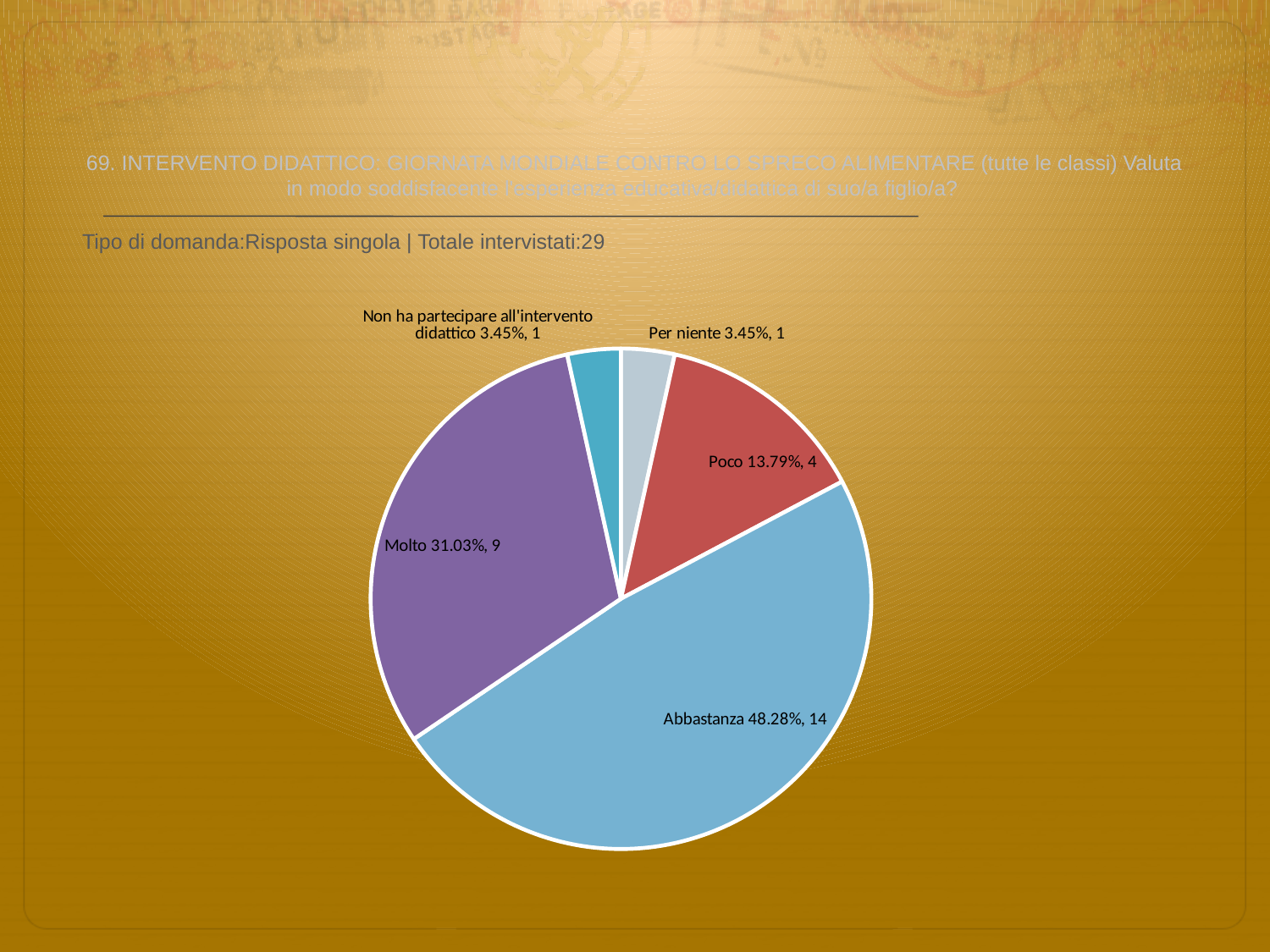
How many respondents answered "Per niente"? 1 What is the total number of respondents (Totale intervistati) stated on the slide? 29 Which response category has the largest share of the pie? Abbastanza How many respondents answered "Molto"? 9 What kind of chart is shown on the slide? pie chart Which has more respondents, "Poco" or "Molto"? Molto What is the difference in number of respondents between "Abbastanza" and "Molto"? 5 How many slices does the pie chart have? 5 What is the share of the pie for "Non ha partecipare all'intervento didattico"? 3.45% What percentage of respondents answered "Poco"? 13.79% What colour is the "Abbastanza" slice? light blue What percentage of respondents answered "Abbastanza"? 48.28%